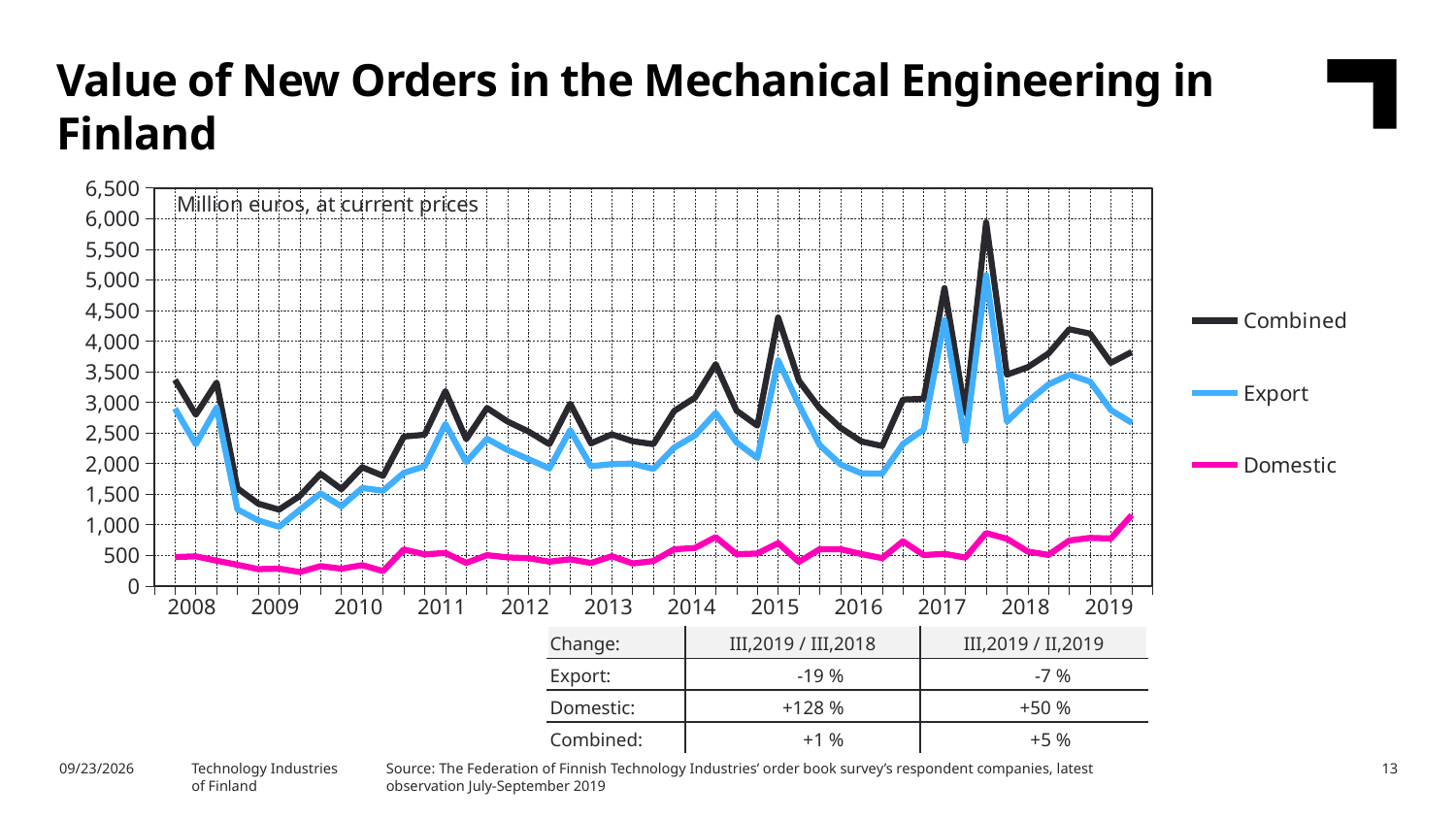
Is the peak value of the Export series in 2017 greater or less than 4,500? greater Which series are listed in the legend? Combined, Export, Domestic Is the peak value of the Combined series in 2017 greater or less than 5,500? greater How many series does the legend list? 3 Which series has the highest values throughout the chart? Combined What unit is stated in the chart for the values? Million euros, at current prices What kind of chart is shown on the slide? line chart Is the Domestic series ever greater or less than 1,500 over the whole period? less How many years are labelled on the x axis? 12 Which series has the lowest values throughout the chart? Domestic Does the Combined series rise or fall from the start of 2008 to 2009? fall